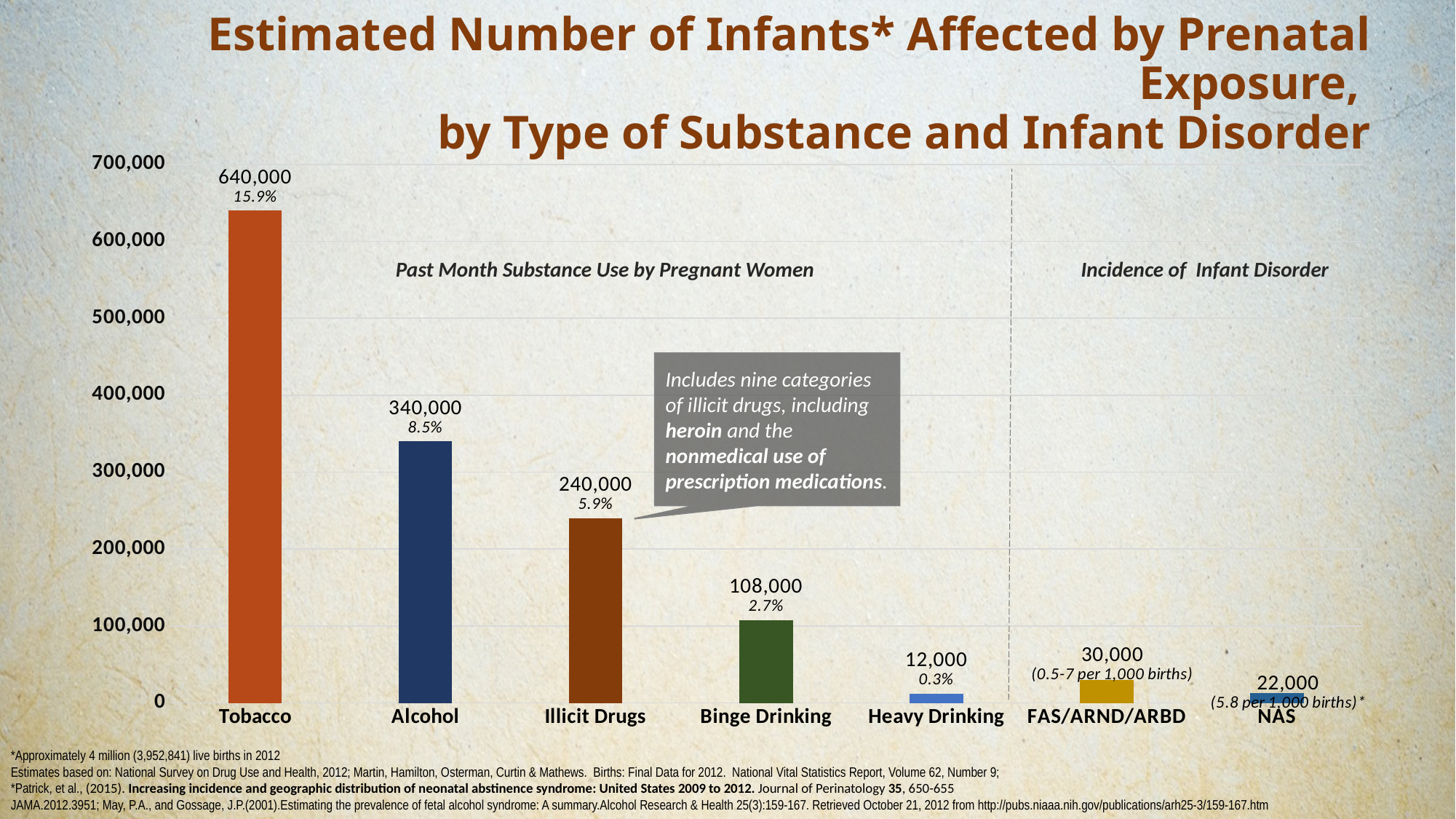
What percentage is shown above the Illicit Drugs bar? 5.9% What kind of chart is shown on the slide? Bar chart Which category has the highest estimated number of infants affected? Tobacco What is the label of the section of the chart to the right of the dashed line? Incidence of Infant Disorder What is the estimated number of infants affected by Binge Drinking? 108,000 Which category has the lowest estimated number of infants affected? Heavy Drinking What is the value shown for NAS? 22,000 What is the difference between the values for Tobacco and Alcohol? 300,000 What is the estimated number of infants affected by prenatal exposure to Tobacco? 640,000 What is the estimated number of infants affected by prenatal exposure to Alcohol? 340,000 Which is larger, the value for FAS/ARND/ARBD or the value for NAS? FAS/ARND/ARBD How many categories are shown on the x axis? 7